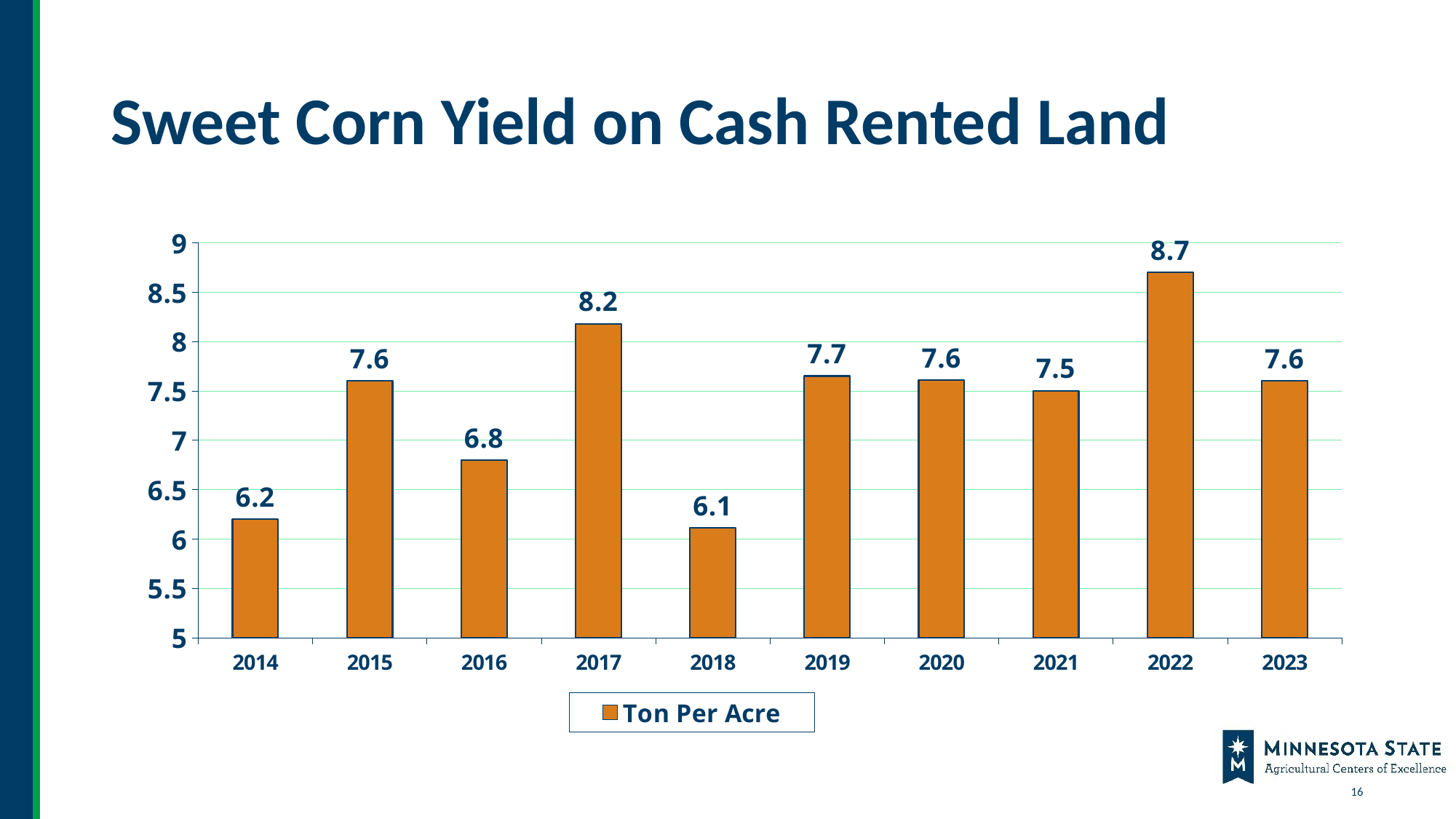
How many series does the legend list? 1 What is the difference in yield between 2017 and 2016? 1.4 What kind of chart is shown on the slide? Bar chart How many years are shown on the chart? 10 What is the title of the chart? Sweet Corn Yield on Cash Rented Land Which year had a higher yield, 2019 or 2021? 2019 Which year has the highest sweet corn yield? 2022 Which year has the lowest sweet corn yield? 2018 What is the sweet corn yield in tons per acre for 2014? 6.2 What is the sweet corn yield in tons per acre for 2021? 7.5 What is the sweet corn yield in tons per acre for 2017? 8.2 What is the difference in yield between 2022 and 2018? 2.6